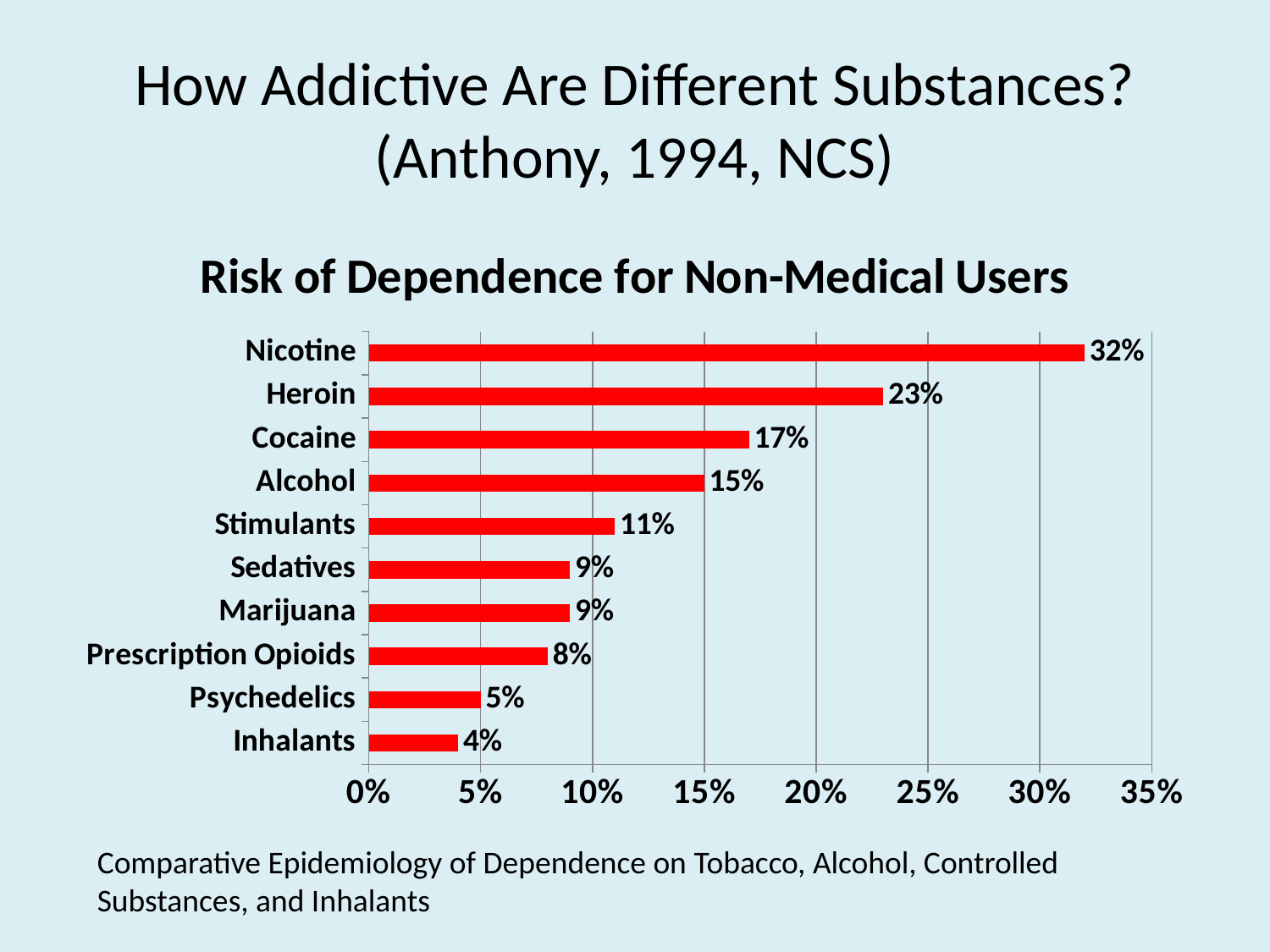
What is the risk of dependence value for Prescription Opioids? 8% What is the difference between the values for Nicotine and Heroin? 9% What is the risk of dependence value for Stimulants? 11% How many substances are shown in the chart? 10 Is the value for Cocaine greater or less than 15%? greater What kind of chart is shown on the slide? Bar chart Which has a higher risk of dependence, Alcohol or Stimulants? Alcohol Which substance has the lowest risk of dependence? Inhalants Which substance has the highest risk of dependence? Nicotine What is the difference between the values for Cocaine and Alcohol? 2% What is the title of the chart? Risk of Dependence for Non-Medical Users What is the risk of dependence value for Heroin? 23%